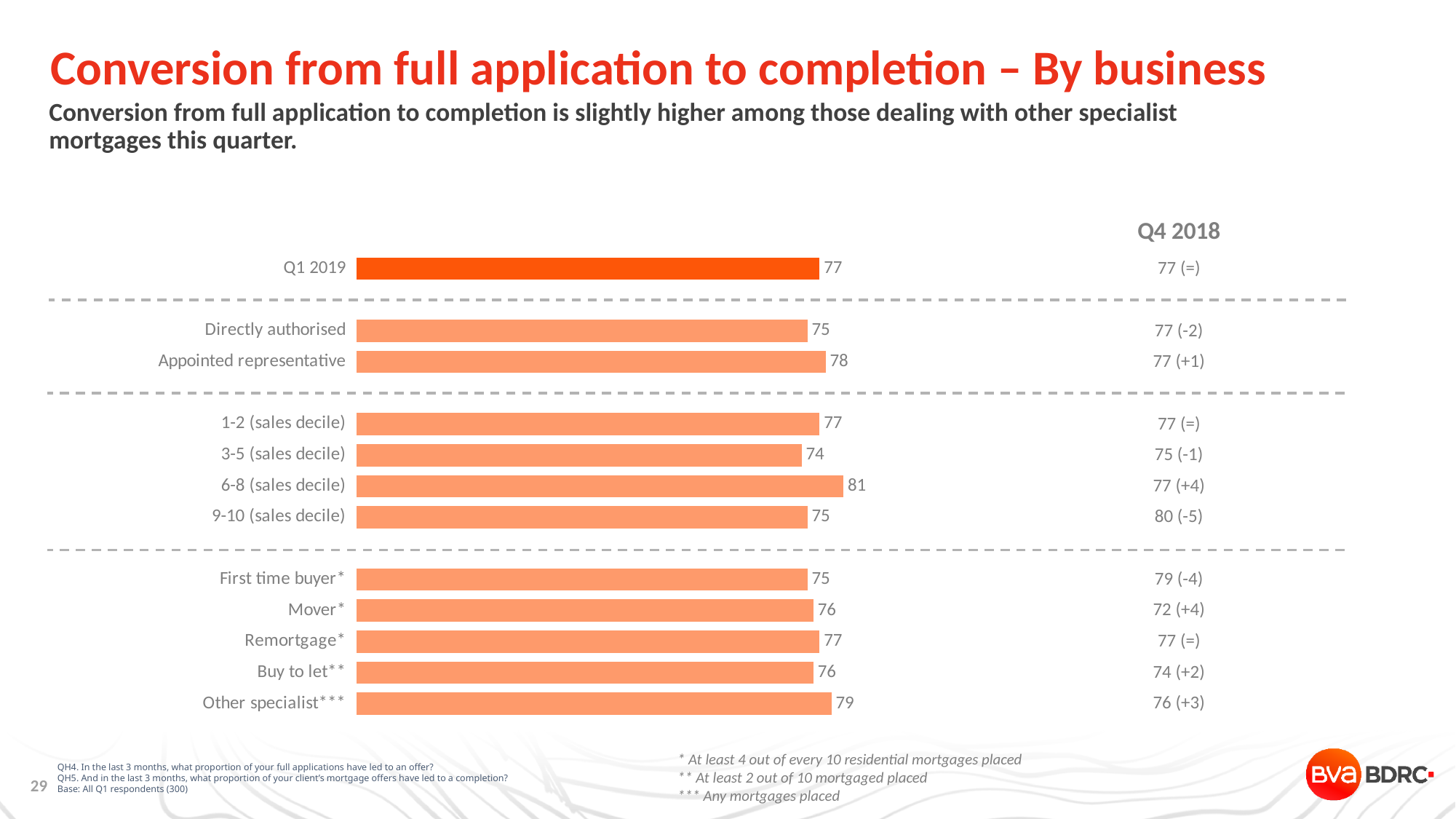
What is the value for 6-8 (sales decile)? 81 How many bars are plotted in the chart? 12 What is the difference between the values for 6-8 (sales decile) and 3-5 (sales decile)? 7 What kind of chart is shown on the slide? Bar chart What is the Q4 2018 value shown for 9-10 (sales decile)? 80 (-5) What is the value for Other specialist? 79 What is the value for Q1 2019 overall? 77 Which is larger, the value for Other specialist or the value for First time buyer? Other specialist What is the value for Appointed representative? 78 What is the difference between the values for Appointed representative and Directly authorised? 3 Which category has the lowest value? 3-5 (sales decile) Which category has the highest value? 6-8 (sales decile)